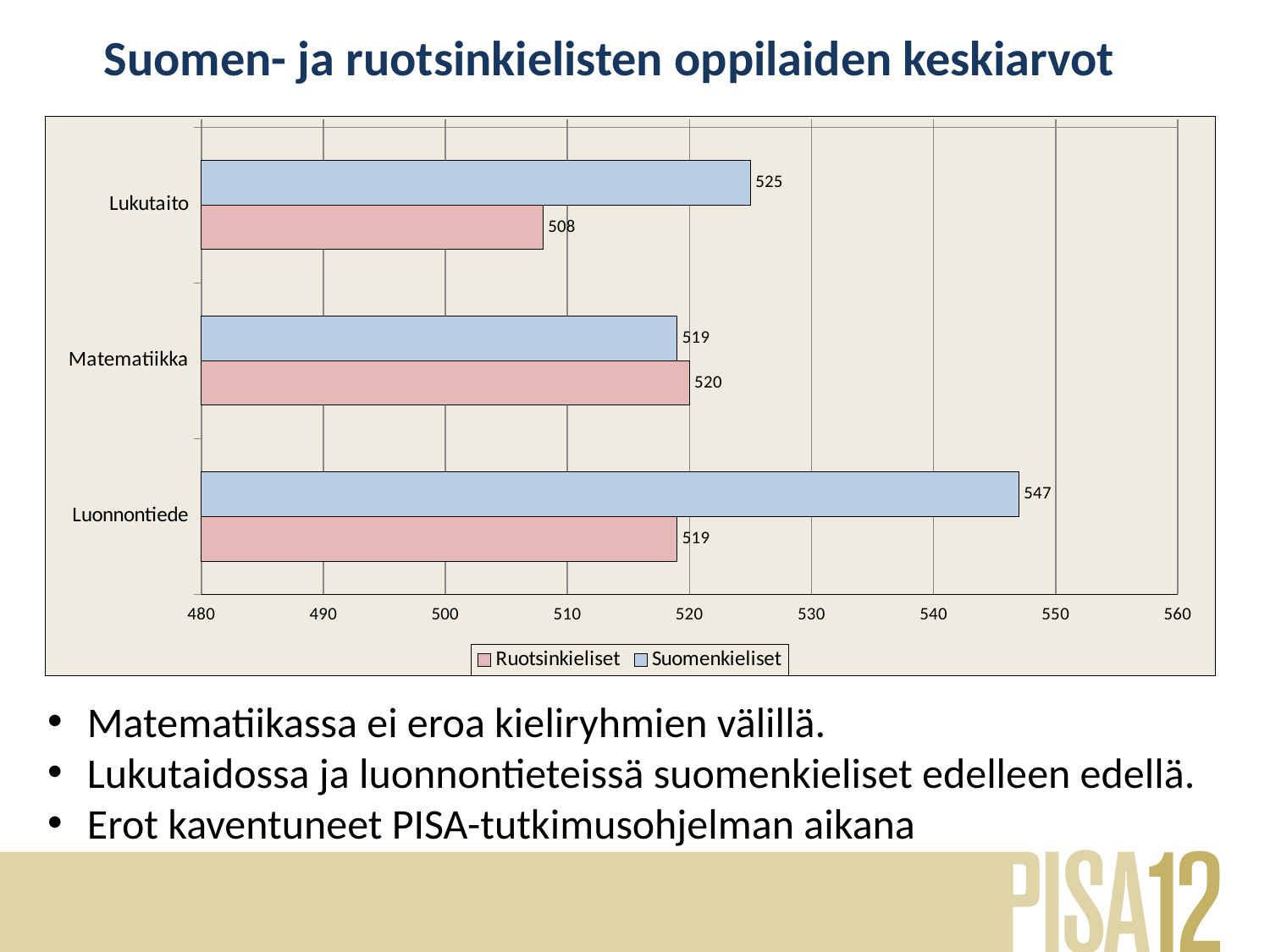
How many categories are shown on the chart? 3 What is the difference between Suomenkieliset and Ruotsinkieliset in Luonnontiede? 28 What is the value for Ruotsinkieliset in Matematiikka? 520 What kind of chart is shown on the slide? Bar chart How many series does the legend list? 2 In which category does Ruotsinkieliset have the lowest value? Lukutaito What is the value for Suomenkieliset in Luonnontiede? 547 What is the value for Suomenkieliset in Lukutaito? 525 What is the value for Ruotsinkieliset in Lukutaito? 508 In which category does Suomenkieliset have the highest value? Luonnontiede What is the difference between Suomenkieliset and Ruotsinkieliset in Lukutaito? 17 Which series has the larger value in Lukutaito, Suomenkieliset or Ruotsinkieliset? Suomenkieliset